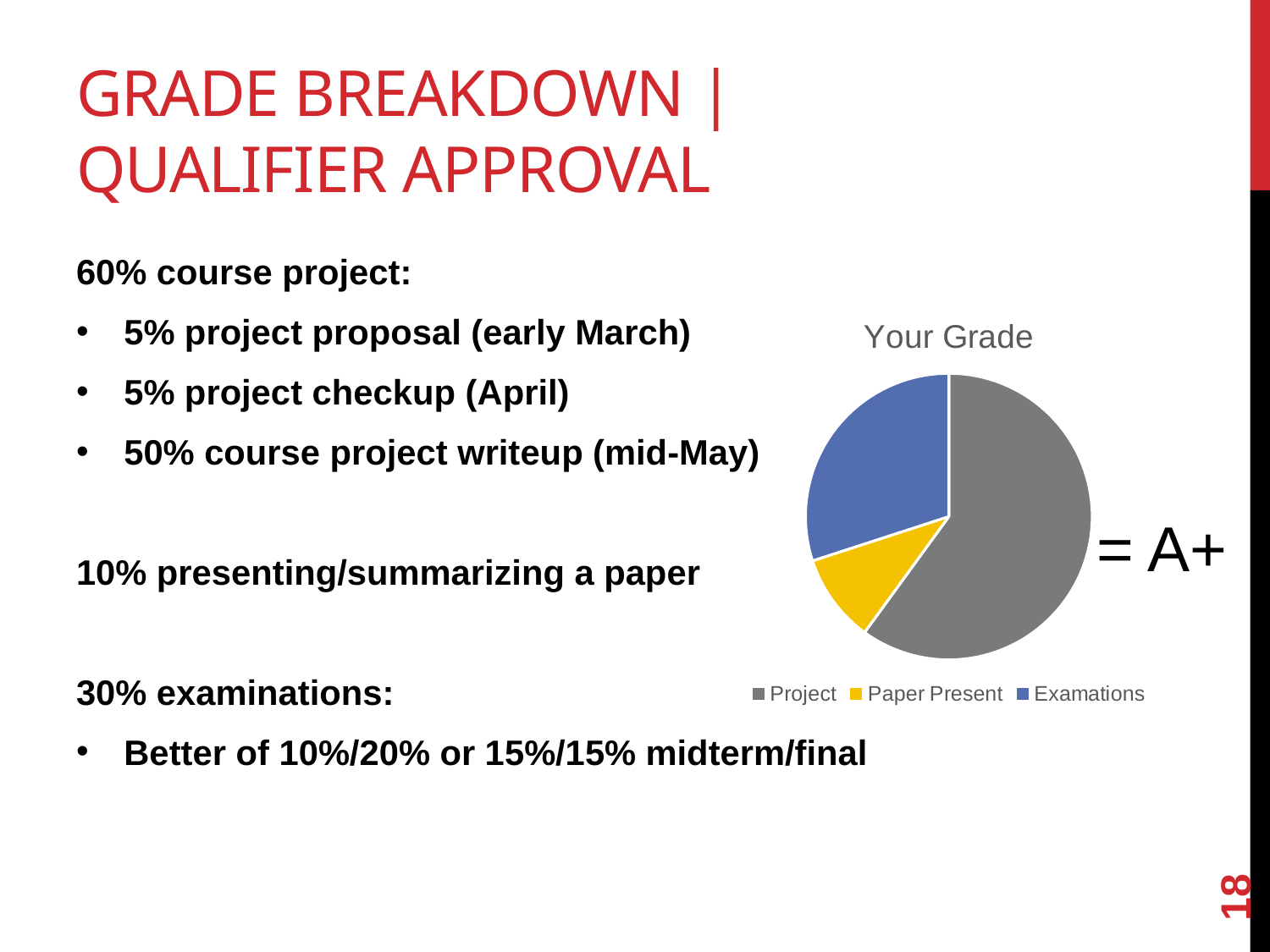
Which slice of the pie chart is the largest? Project Which slice is larger in the pie chart, Examations or Paper Present? Examations Does the Project slice take up more or less than half of the pie chart? more Which slice of the pie chart is the smallest? Paper Present What kind of chart is shown on the slide? pie chart Which slice is larger in the pie chart, Project or Examations? Project How many slices does the pie chart have? 3 How many entries does the legend of the pie chart list? 3 What is the title of the pie chart? Your Grade What colour is the Paper Present slice in the pie chart? yellow